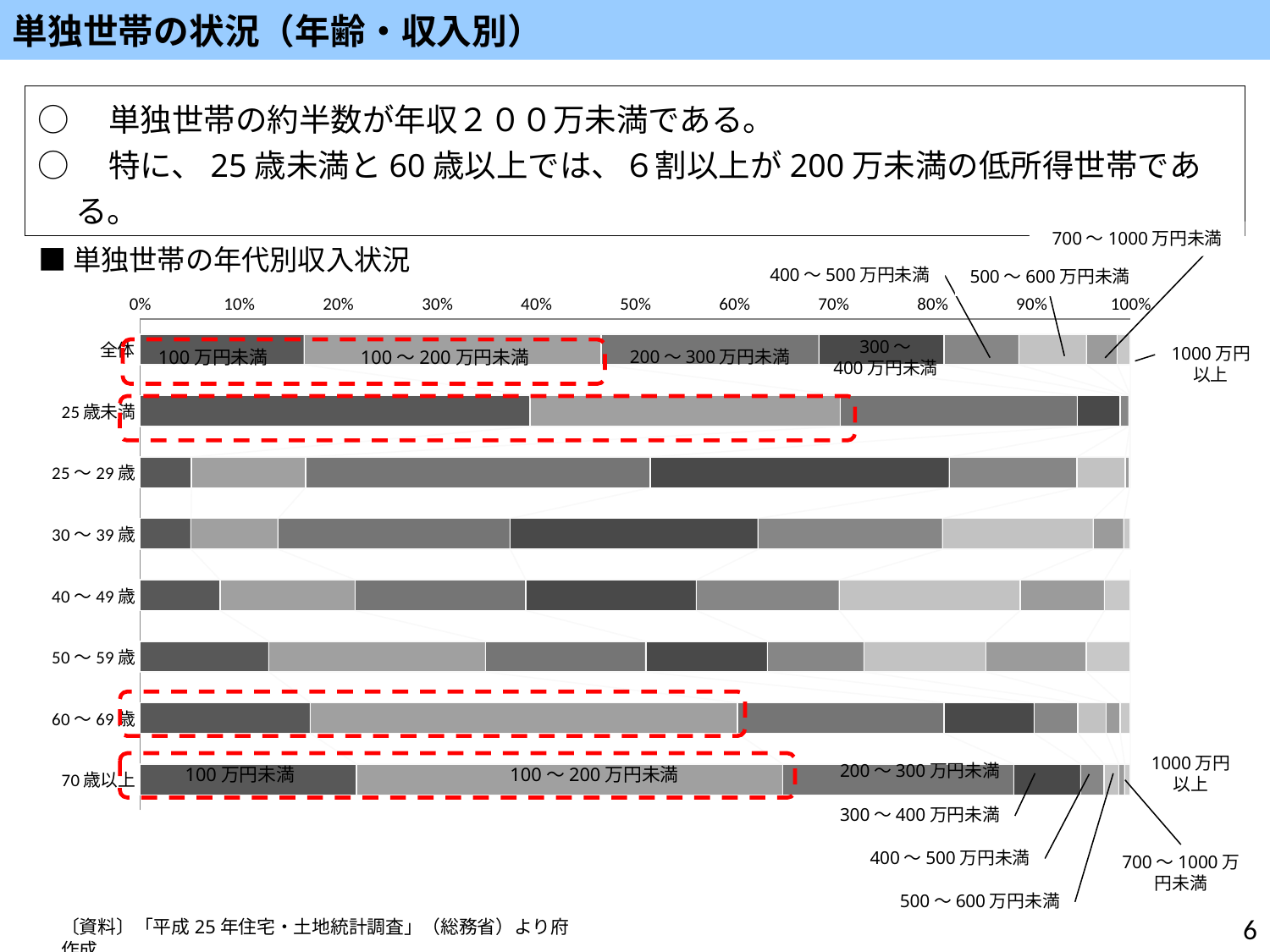
Which has a larger 100万円未満 share: 25歳未満 or 25～29歳? 25歳未満 Is the 100万円未満 share for 25歳未満 greater or less than 30%? greater Is the combined share of households under 200万円 for 70歳以上 greater or less than 60%? greater What kind of chart is shown on the slide? Stacked bar chart Which has a larger 100万円未満 share: 70歳以上 or 30～39歳? 70歳以上 Is the 100万円未満 share for 25～29歳 greater or less than 10%? less How many age-group categories (including 全体) are plotted on the chart? 8 Which age group has the largest share of 100万円未満 households? 25歳未満 What is the title of the chart? 単独世帯の年代別収入状況